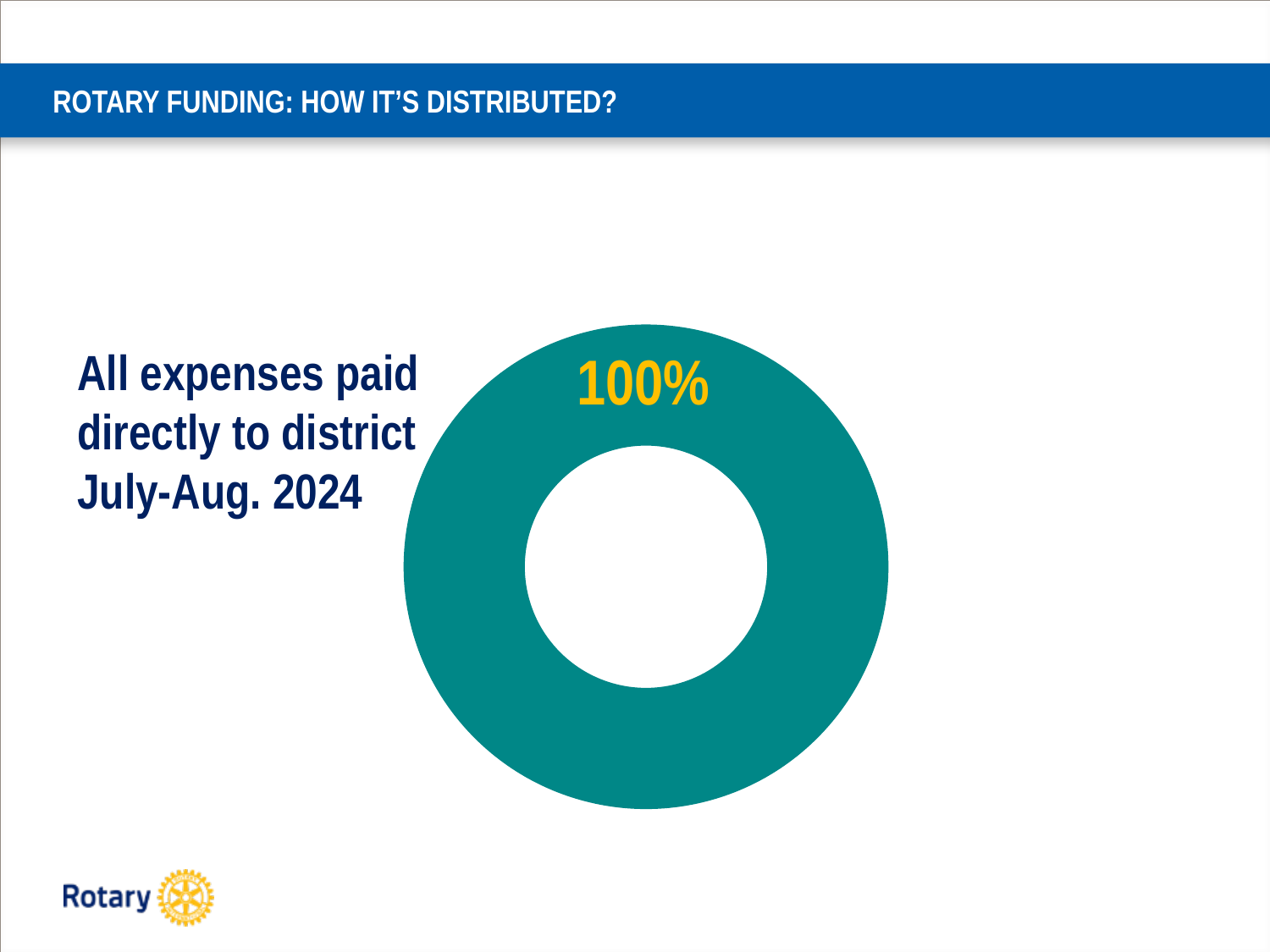
How many slices does the doughnut chart have? 1 What percentage is printed on the doughnut chart? 100% What share of the doughnut does the single slice represent? 100% What kind of chart is shown on the slide? Doughnut chart What is the slide title above the chart? ROTARY FUNDING: HOW IT'S DISTRIBUTED? Is the value shown on the doughnut chart greater or less than 50%? greater What colour is the slice of the doughnut chart? Teal